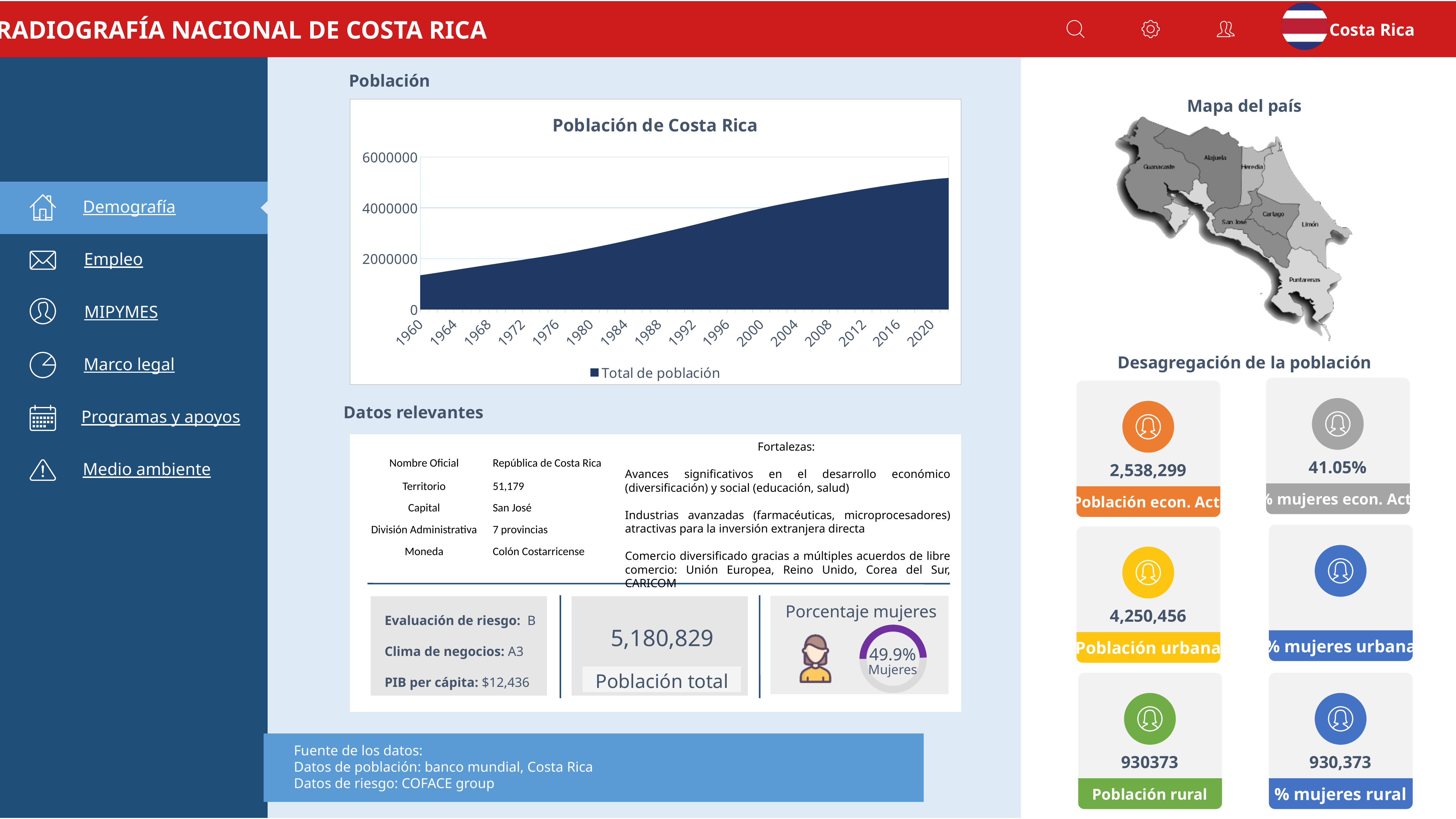
In the 'Población de Costa Rica' chart, is the value for 1992 greater or less than 4000000? less In the 'Población de Costa Rica' chart, which is larger, the value for 1976 or the value for 2008? 2008 In the 'Población de Costa Rica' chart, is the value for 2020 greater or less than 4000000? greater In the 'Población de Costa Rica' chart, which labelled year has the highest population? 2020 In the 'Porcentaje mujeres' donut chart, what share is labelled for Mujeres? 49.9% In the 'Población de Costa Rica' chart, is the value for 1984 greater or less than 2000000? greater How many series does the legend of the 'Población de Costa Rica' chart list? 1 What kind of chart is 'Población de Costa Rica'? area chart In the 'Población de Costa Rica' chart, do the values rise or fall from 1960 to 2020? rise In the 'Población de Costa Rica' chart, which labelled year has the lowest population? 1960 What is the legend entry of the 'Población de Costa Rica' chart? Total de población